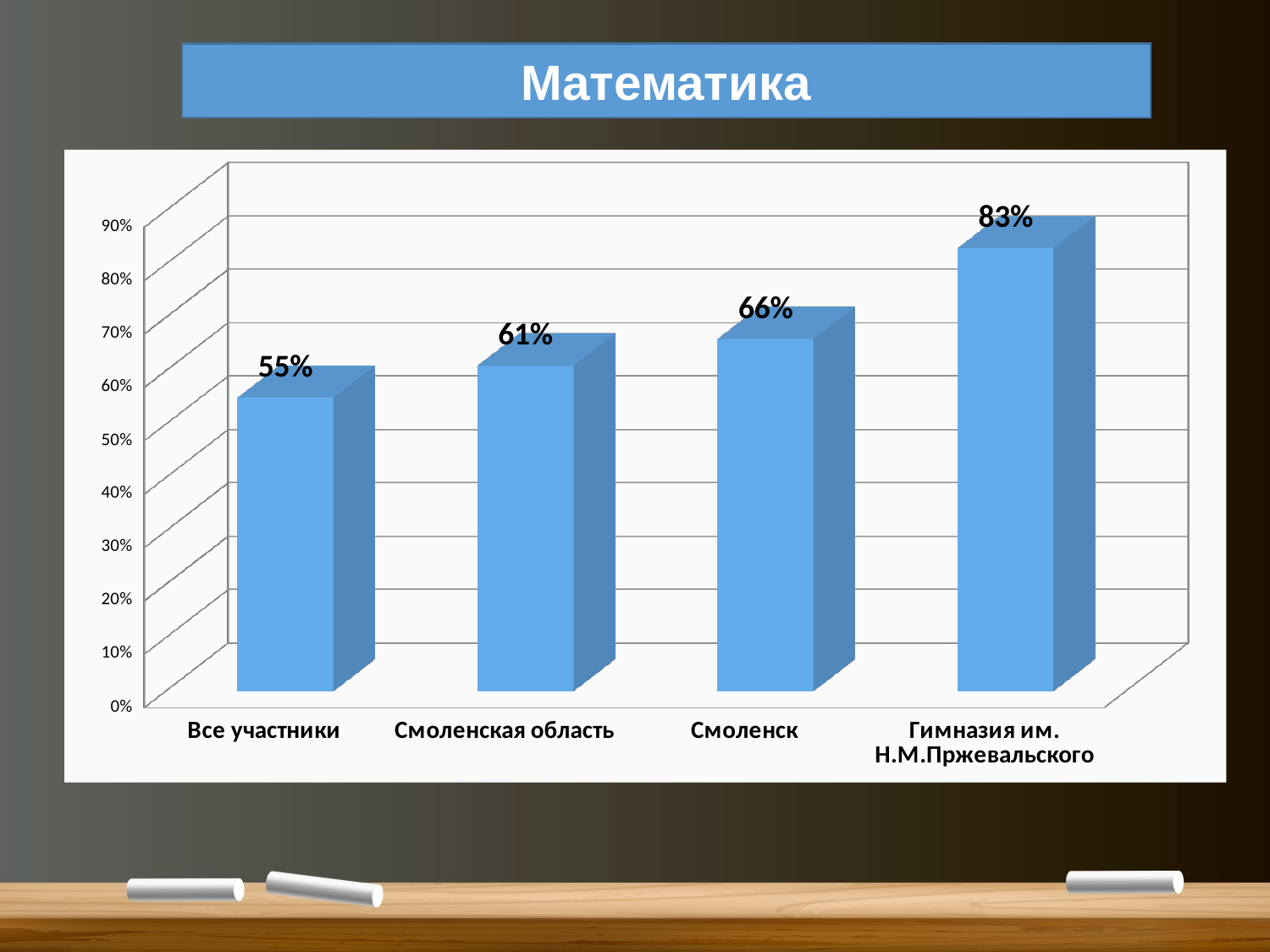
What is the value for Смоленск? 66% Do the values rise or fall from left to right along the x axis? rise Which category has the lowest value? Все участники What is the value for Смоленская область? 61% How many categories are shown on the chart? 4 What is the value for Все участники? 55% What is the difference between the values for Гимназия им. Н.М.Пржевальского and Все участники? 28% What is the value for Гимназия им. Н.М.Пржевальского? 83% Which category has the highest value? Гимназия им. Н.М.Пржевальского Which is larger, the value for Смоленск or the value for Смоленская область? Смоленск What is the difference between the values for Смоленск and Смоленская область? 5% What kind of chart is shown on the slide? bar chart